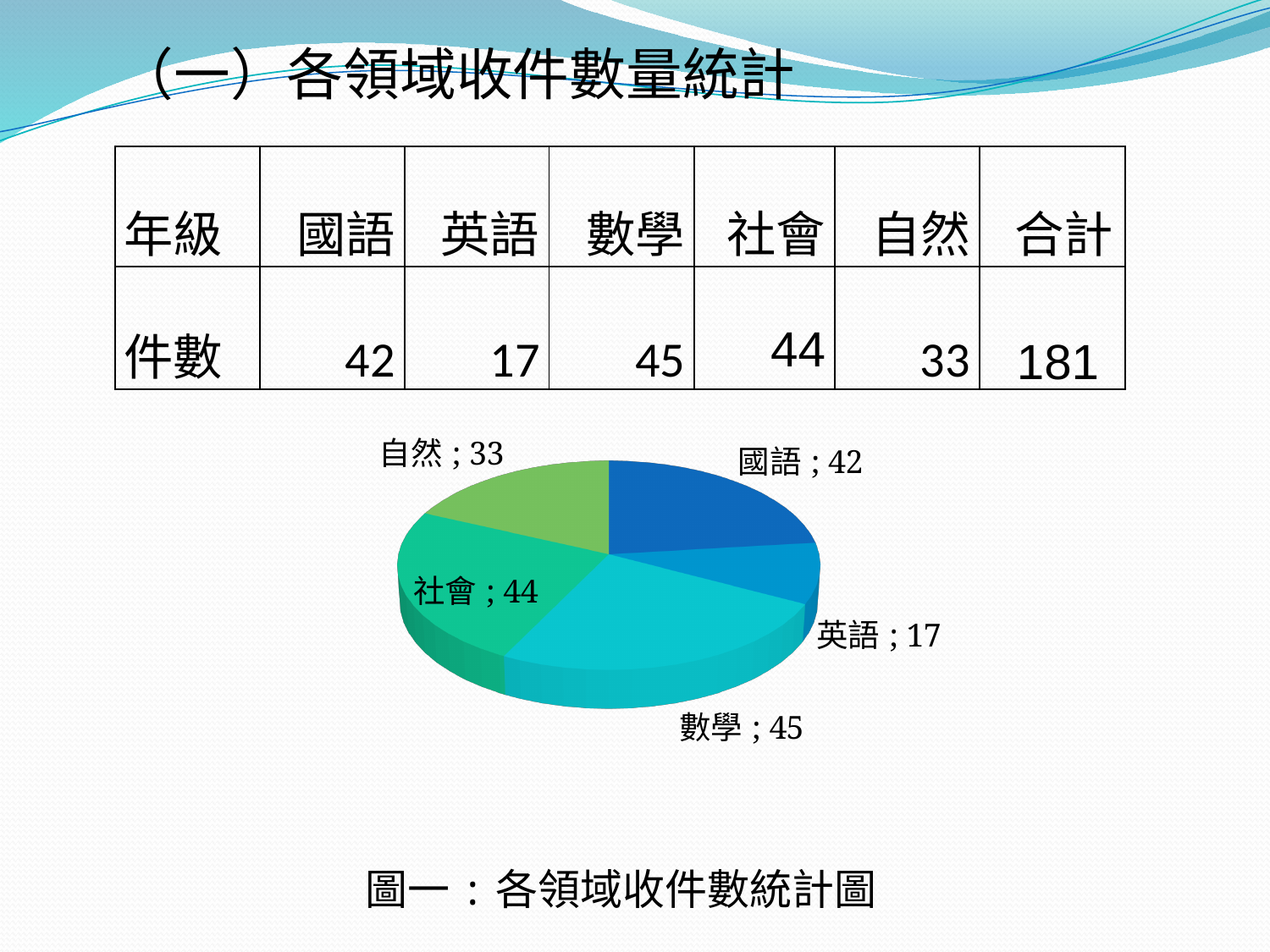
What is the value for 數學 in the pie chart? 45 What is the caption shown below the chart? 圖一：各領域收件數統計圖 Which category has the smallest slice in the pie chart? 英語 Which is larger in the pie chart, 社會 or 國語? 社會 How many slices does the pie chart have? 5 What is the difference between the values for 國語 and 英語 in the pie chart? 25 What kind of chart is shown on the slide? pie chart What is the value for 自然 in the pie chart? 33 Which category has the largest slice in the pie chart? 數學 Which is larger in the pie chart, 自然 or 英語? 自然 What is the difference between the values for 數學 and 自然 in the pie chart? 12 What is the value for 英語 in the pie chart? 17